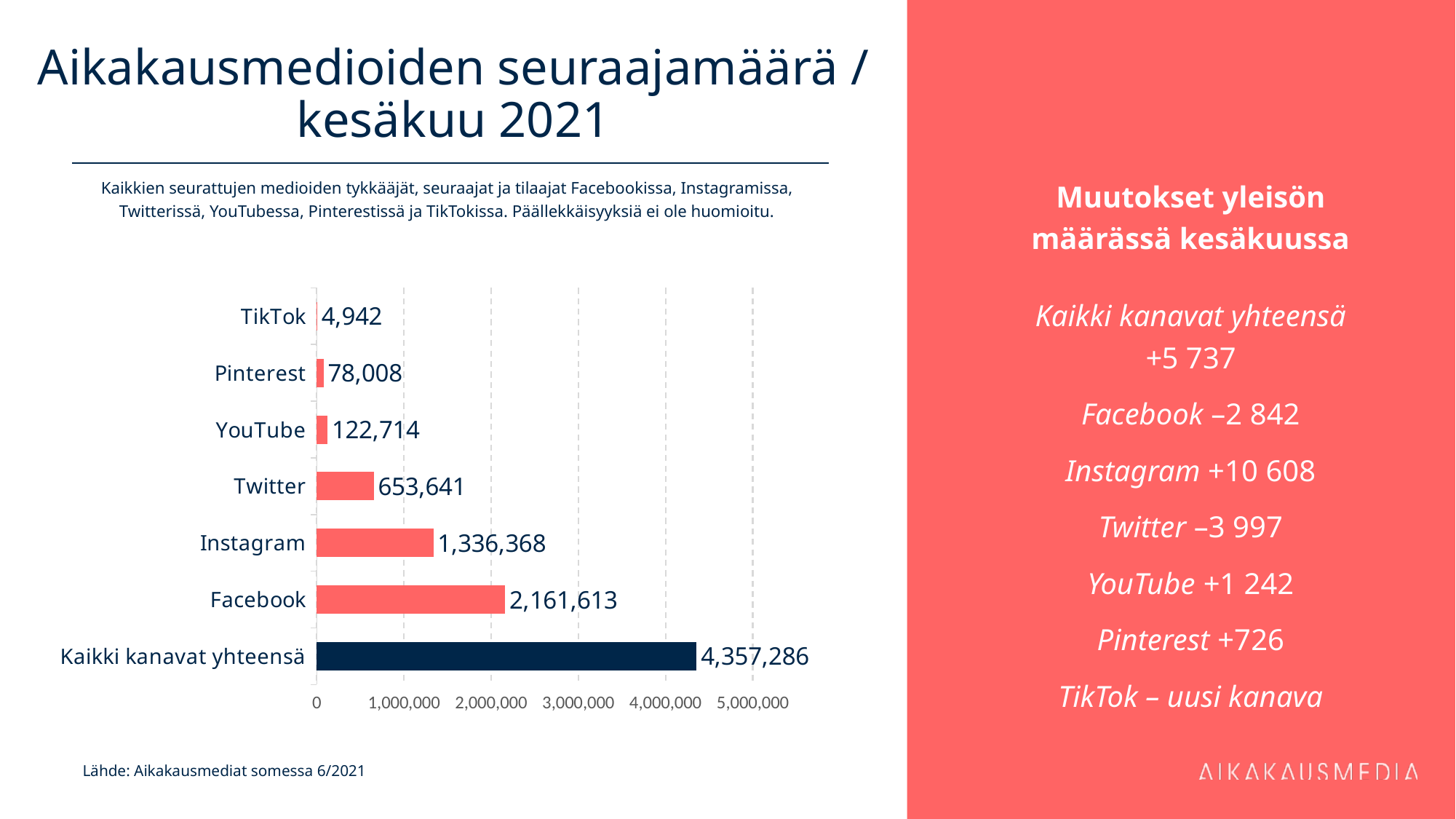
What is the difference between the values for Facebook and Instagram? 825,245 Which has a larger value, Pinterest or YouTube? YouTube What is the difference between the values for Twitter and YouTube? 530,927 How many categories (bars) are shown in the chart? 7 What is the value shown for Kaikki kanavat yhteensä? 4,357,286 What is the value shown for TikTok? 4,942 What is the value shown for Facebook? 2,161,613 Which category has the lowest value in the chart? TikTok Excluding the total bar (Kaikki kanavat yhteensä), which individual channel has the highest value? Facebook What is the value shown for Instagram? 1,336,368 Is the value for Twitter greater or less than 1,000,000? less What kind of chart is shown on the slide? bar chart